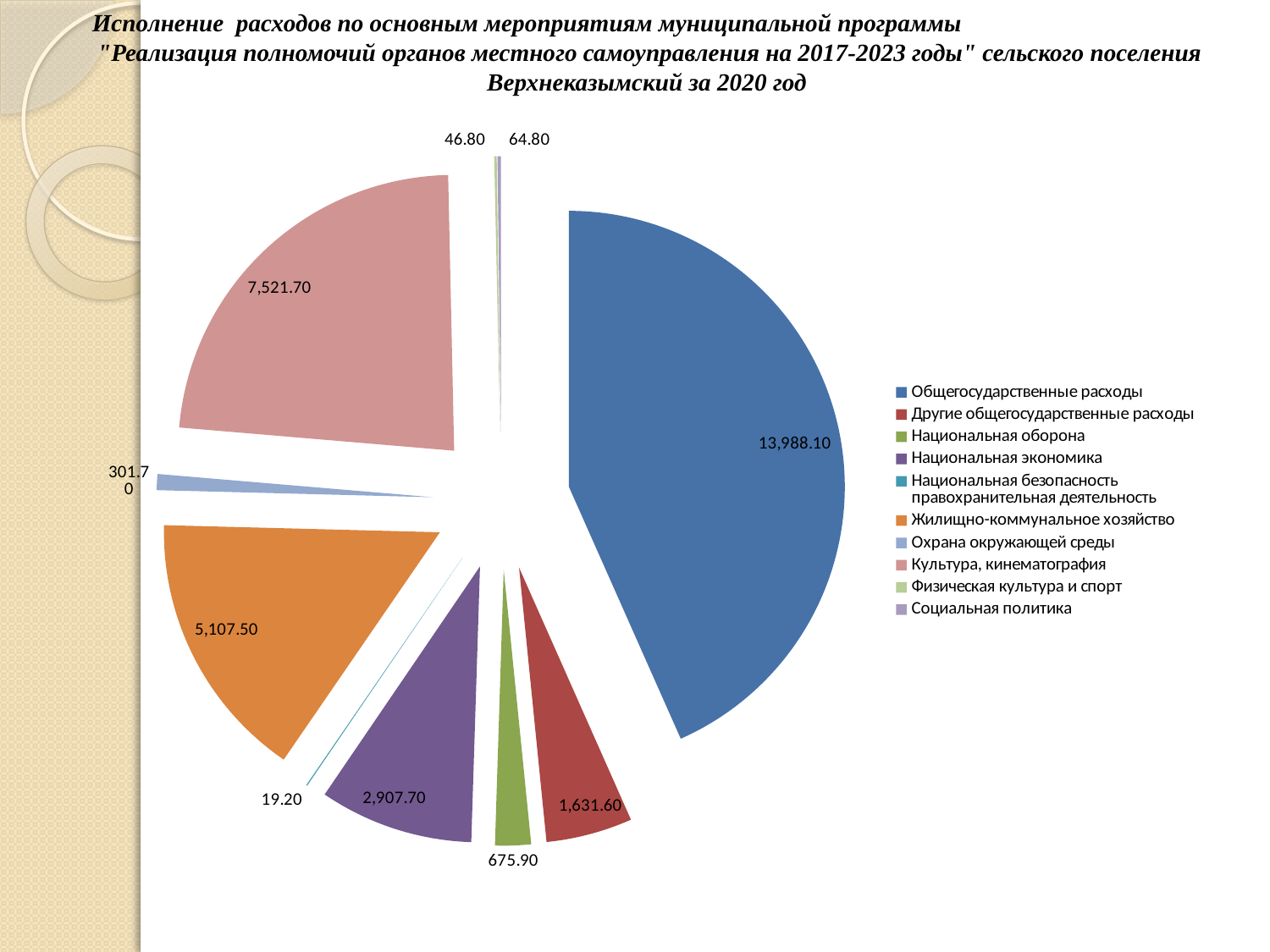
Which category has the largest slice of the pie? Общегосударственные расходы What is the difference between the values for Культура, кинематография and Жилищно-коммунальное хозяйство? 2,414.20 What is the value for Национальная безопасность и правоохранительная деятельность? 19.20 What colour is the slice for Жилищно-коммунальное хозяйство? orange What is the value for Общегосударственные расходы? 13,988.10 What is the value for Культура, кинематография? 7,521.70 What is the value for Жилищно-коммунальное хозяйство? 5,107.50 What is the value for Национальная экономика? 2,907.70 Which is larger: Другие общегосударственные расходы or Национальная оборона? Другие общегосударственные расходы What kind of chart is shown on the slide? pie chart Which category has the smallest value? Национальная безопасность и правоохранительная деятельность How many categories does the pie chart have? 10